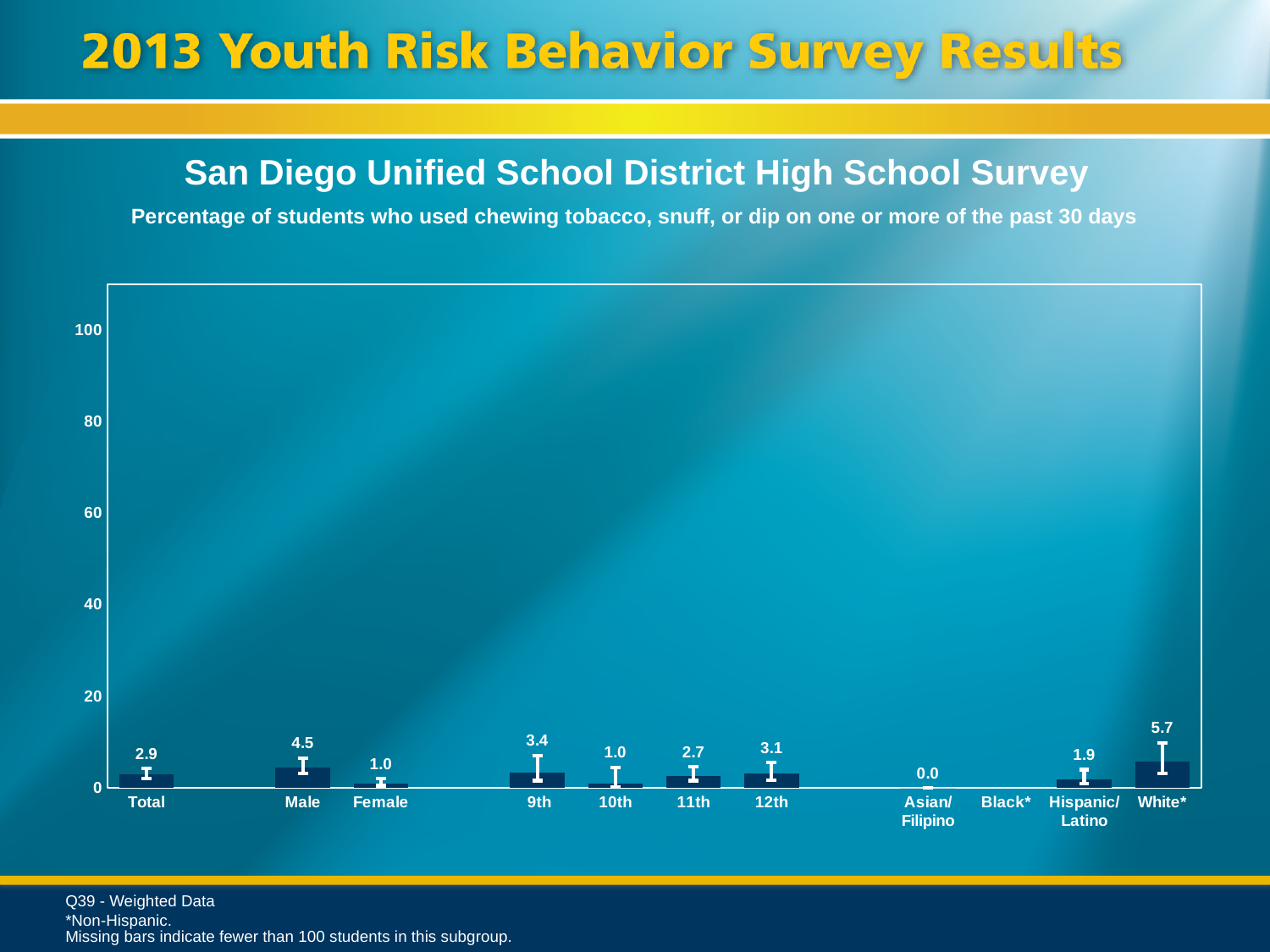
Which category has the lowest value? Asian/Filipino What is the difference between the values for White* and Hispanic/Latino? 3.8 Which category has the highest value? White* What is the value for 9th? 3.4 What is the value for Hispanic/Latino? 1.9 What kind of chart is shown on the slide? bar chart What is the difference between the values for Male and Female? 3.5 According to the footnote, what do missing bars indicate? Fewer than 100 students in this subgroup Which is larger, the value for 12th or the value for 11th? 12th What is the value for Male? 4.5 Is the value for White* greater or less than 20? less What is the value for Total? 2.9